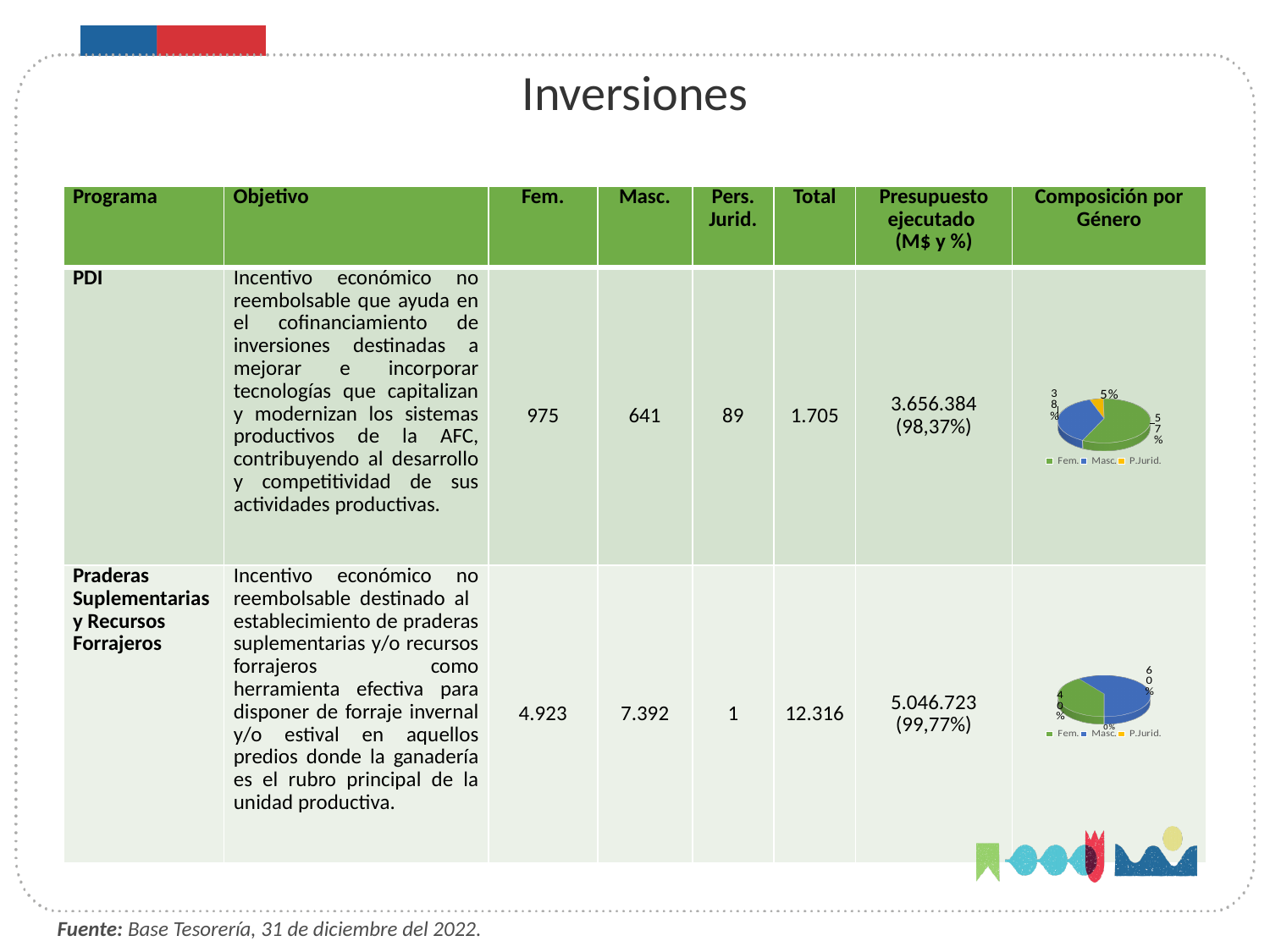
In the pie chart in the PDI row, what share is labelled for Masc.? 38% In the pie chart in the PDI row, which category has the largest slice? Fem. In the pie chart in the Praderas Suplementarias y Recursos Forrajeros row, what share is labelled for Masc.? 60% In the pie chart in the PDI row, which category has the smallest slice? P.Jurid. In the pie chart in the PDI row, what share is labelled for P.Jurid.? 5% What kind of chart is shown in the Composición por Género column of the PDI row? Pie chart In the pie chart in the Praderas Suplementarias y Recursos Forrajeros row, which category has the largest slice? Masc. In the pie chart in the PDI row, which colour represents Fem.? Green In the pie chart in the PDI row, which is larger, the Fem. slice or the Masc. slice? Fem. How many entries does the legend of the pie chart in the PDI row list? 3